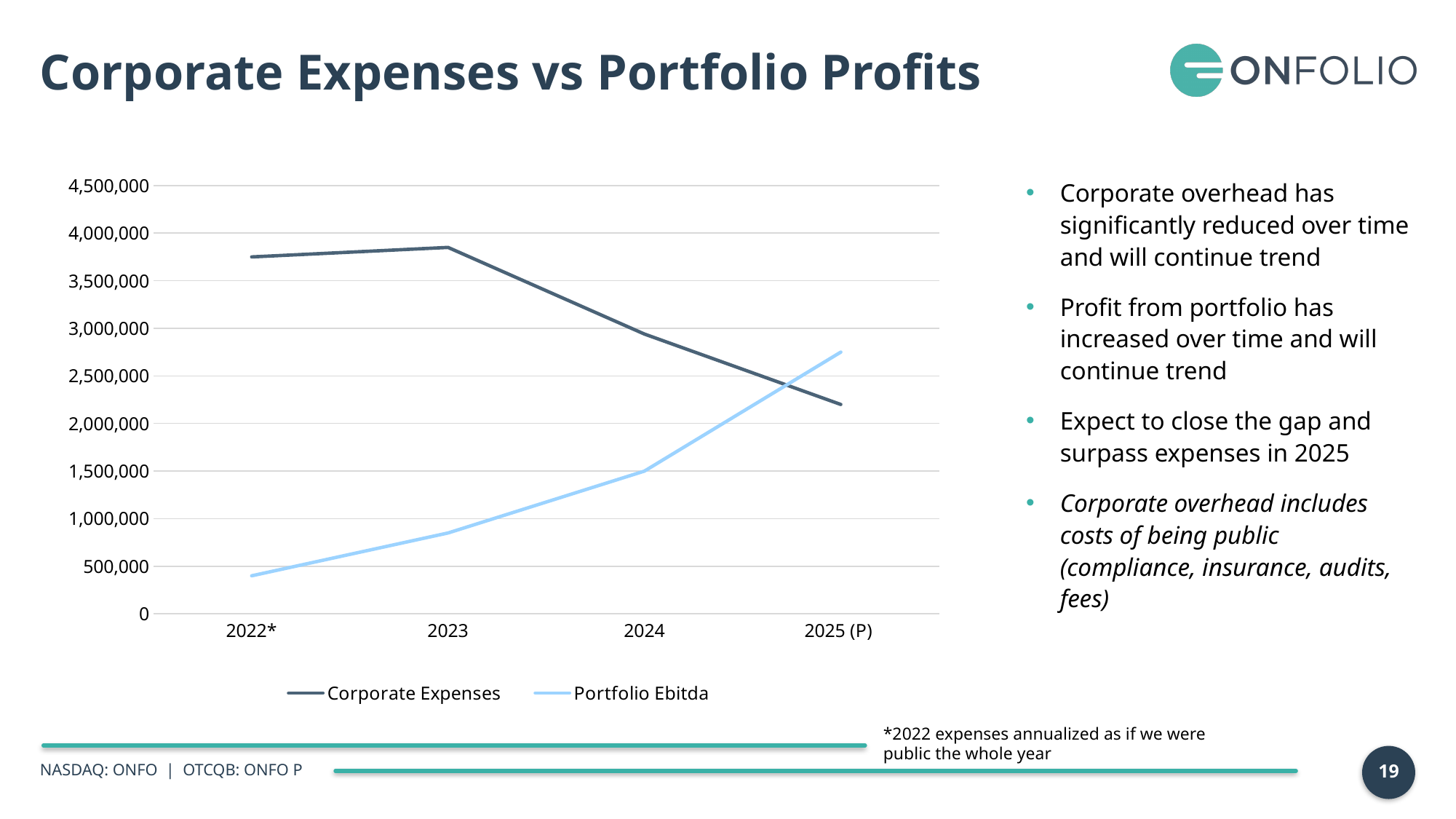
In which year is Portfolio Ebitda highest? 2025 (P) In 2025 (P), which is larger: Corporate Expenses or Portfolio Ebitda? Portfolio Ebitda Does Corporate Expenses rise or fall from 2023 to 2025 (P)? Fall Is the value for Portfolio Ebitda in 2023 greater or less than 1,000,000? less Does Portfolio Ebitda rise or fall from 2022* to 2025 (P)? Rise In which year is Corporate Expenses lowest? 2025 (P) What kind of chart is shown on the slide? Line chart What is the title of the chart? Corporate Expenses vs Portfolio Profits Which series is shown in the light blue line? Portfolio Ebitda How many series does the legend list? 2 How many years are plotted along the x axis? 4 Is the value for Corporate Expenses in 2024 greater or less than 2,500,000? greater